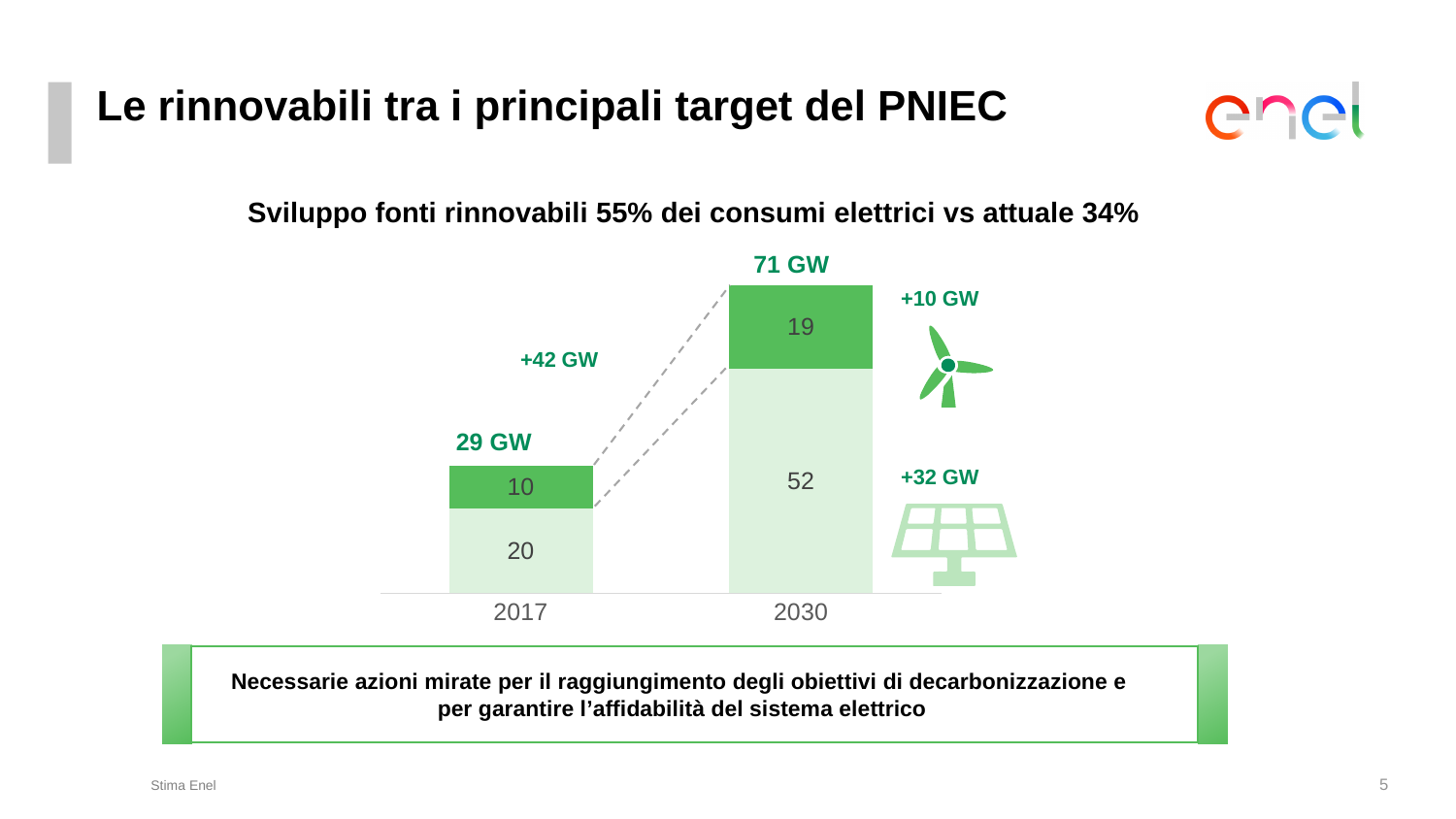
What is the difference between the light green bottom segments of the 2030 and 2017 bars? 32 What is the total value labelled above the 2030 bar? 71 GW What kind of chart is shown on the slide? stacked bar chart What value is printed in the light green bottom segment of the 2030 bar? 52 How many years (categories) are shown on the x axis of the chart? 2 By how much does the total increase from 2017 to 2030, as labelled on the chart? +42 GW What value is printed in the dark green top segment of the 2030 bar? 19 Which year has the higher total, 2017 or 2030? 2030 Do the bar totals rise or fall from 2017 to 2030? rise What value is printed in the light green bottom segment of the 2017 bar? 20 What value is printed in the dark green top segment of the 2017 bar? 10 What is the total value labelled above the 2017 bar? 29 GW